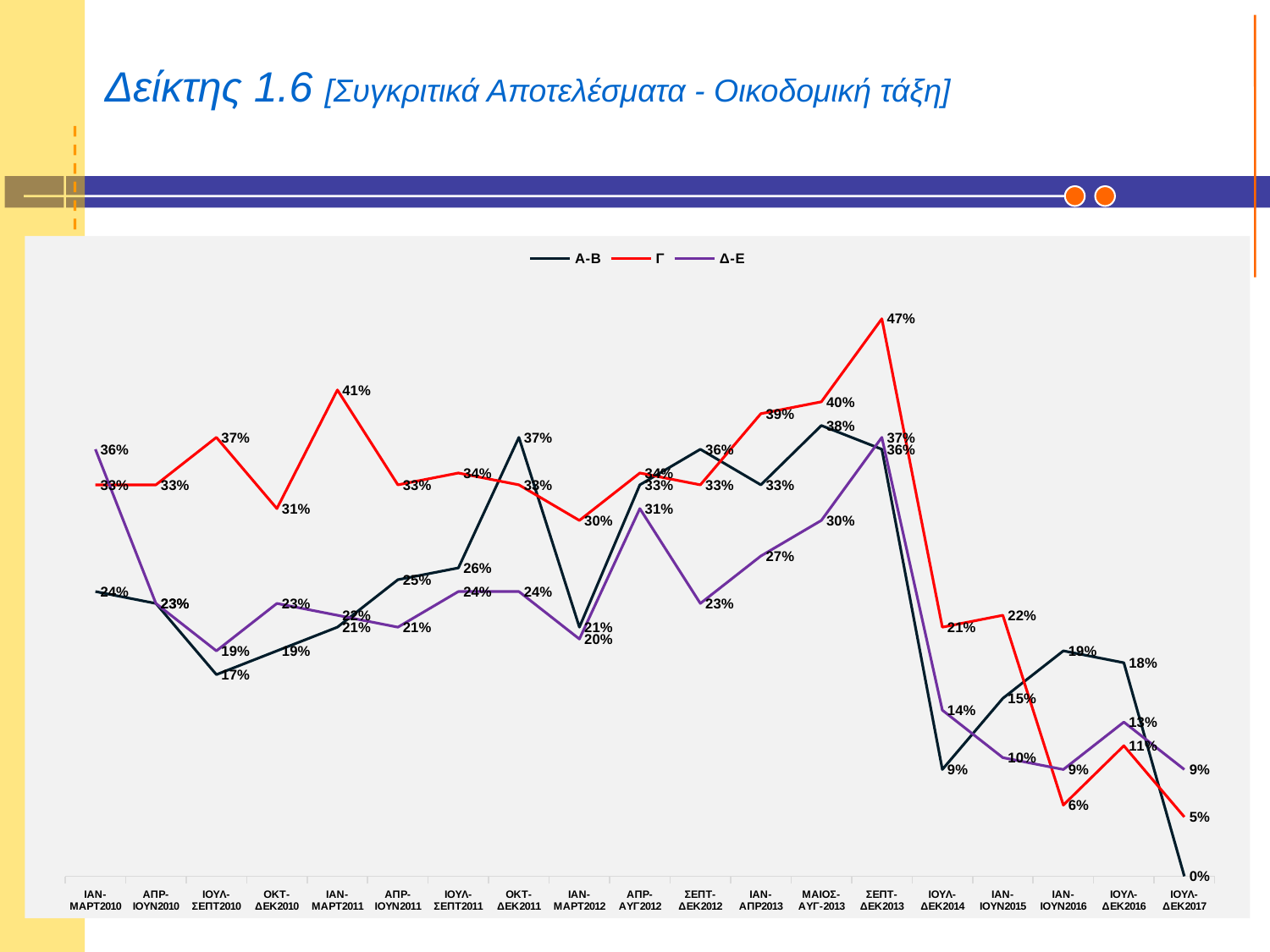
Does the Γ series rise or fall from ΣΕΠΤ-ΔΕΚ2013 to ΙΟΥΛ-ΔΕΚ2017? Fall How many time periods are shown on the x axis? 19 How many series does the legend list? 3 In which period does the Α-Β series reach its lowest value? ΙΟΥΛ-ΔΕΚ2017 What is the value of the Α-Β series for ΙΟΥΛ-ΔΕΚ2017? 0% For ΙΟΥΛ-ΔΕΚ2014, which series has the higher value, Γ or Α-Β? Γ In which period does the Γ series reach its highest value? ΣΕΠΤ-ΔΕΚ2013 What is the value of the Δ-Ε series for ΙΟΥΛ-ΔΕΚ2014? 14% What type of chart is shown on the slide? Line chart What is the value of the Γ series for ΙΑΝ-ΙΟΥΝ2016? 6% What is the difference between the Γ and Α-Β values for ΙΑΝ-ΜΑΡΤ2011? 20 percentage points What is the value of the Γ series for ΣΕΠΤ-ΔΕΚ2013? 47%